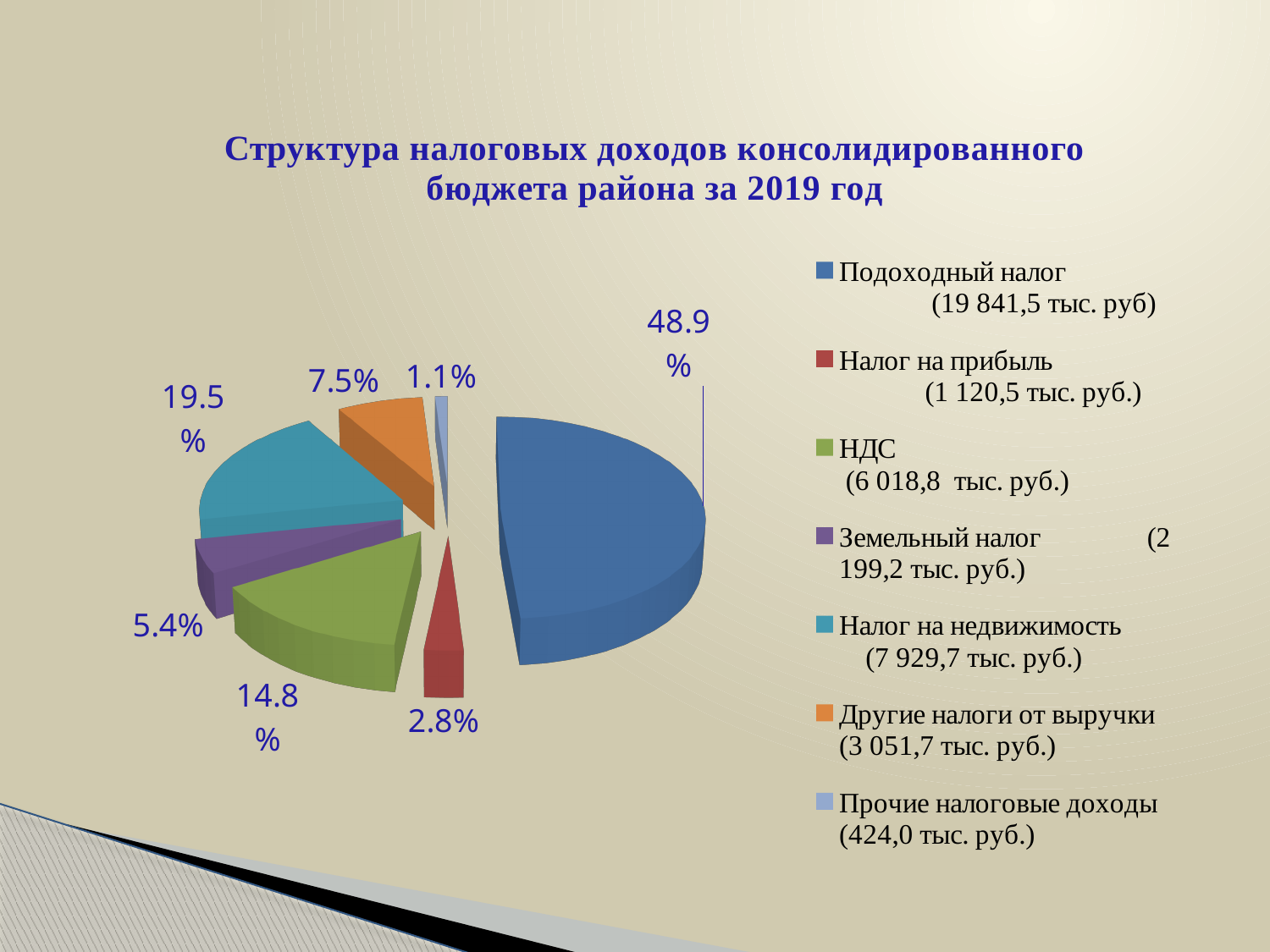
What is the title of the chart? Структура налоговых доходов консолидированного бюджета района за 2019 год Which category has the smallest slice of the pie? Прочие налоговые доходы What share of the pie does Налог на недвижимость have? 19.5% Which category has the largest slice of the pie? Подоходный налог What share of the pie does Налог на прибыль have? 2.8% What share of the pie does НДС have? 14.8% What type of chart is shown on the slide? pie chart Which has a larger share, Земельный налог or Другие налоги от выручки? Другие налоги от выручки How many slices does the pie chart have? 7 According to the legend, what is the amount for Подоходный налог? 19 841,5 тыс. руб What is the difference in percentage points between the shares of Налог на недвижимость and НДС? 4.7